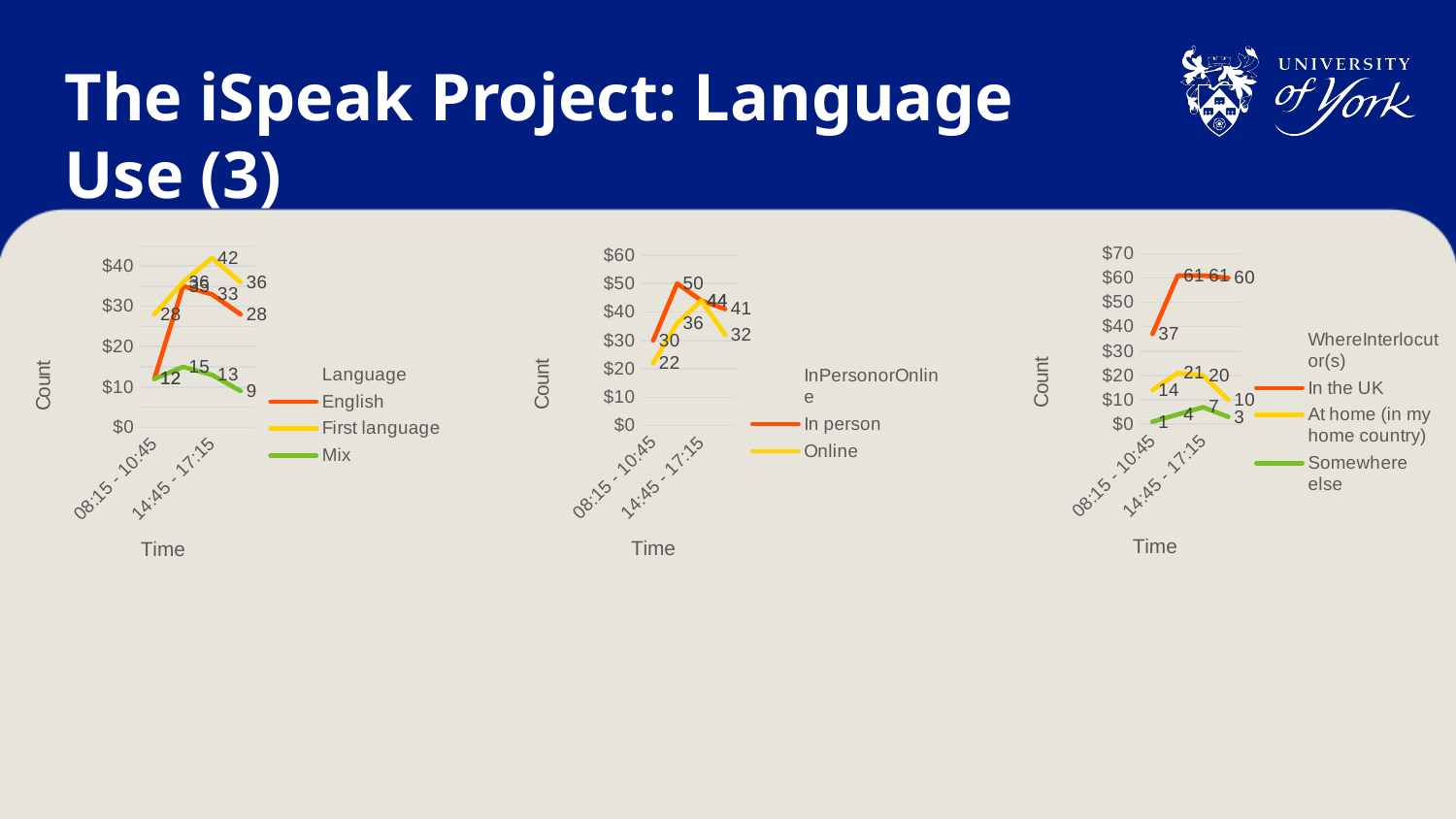
In the middle 'InPersonorOnline' chart, what is the value of the Online series at the first time slot, 08:15 - 10:45? 22 In the right-hand 'WhereInterlocutor(s)' chart, what is the difference between the highest value of the In the UK series (61) and the highest value of the At home (in my home country) series (21)? 40 Which series in the right-hand 'WhereInterlocutor(s)' chart is drawn in green? Somewhere else In the left-hand 'Language' chart, what is the highest value plotted for the First language series? 42 In the right-hand 'WhereInterlocutor(s)' chart, is the value of the In the UK series at the last time slot greater or less than $50? greater How many series does the legend of the left-hand 'Language' chart list? 3 In the right-hand 'WhereInterlocutor(s)' chart, what is the value of the In the UK series at the first time slot, 08:15 - 10:45? 37 In the middle 'InPersonorOnline' chart, what is the highest value plotted for the In person series? 50 What kind of chart is the left-hand chart with the 'Language' legend? Line chart In the left-hand 'Language' chart, what is the lowest value plotted for the Mix series? 9 In the middle 'InPersonorOnline' chart, which series has the higher value at the first time slot, 08:15 - 10:45: In person or Online? In person In the left-hand 'Language' chart, what is the highest value plotted for the English series? 35